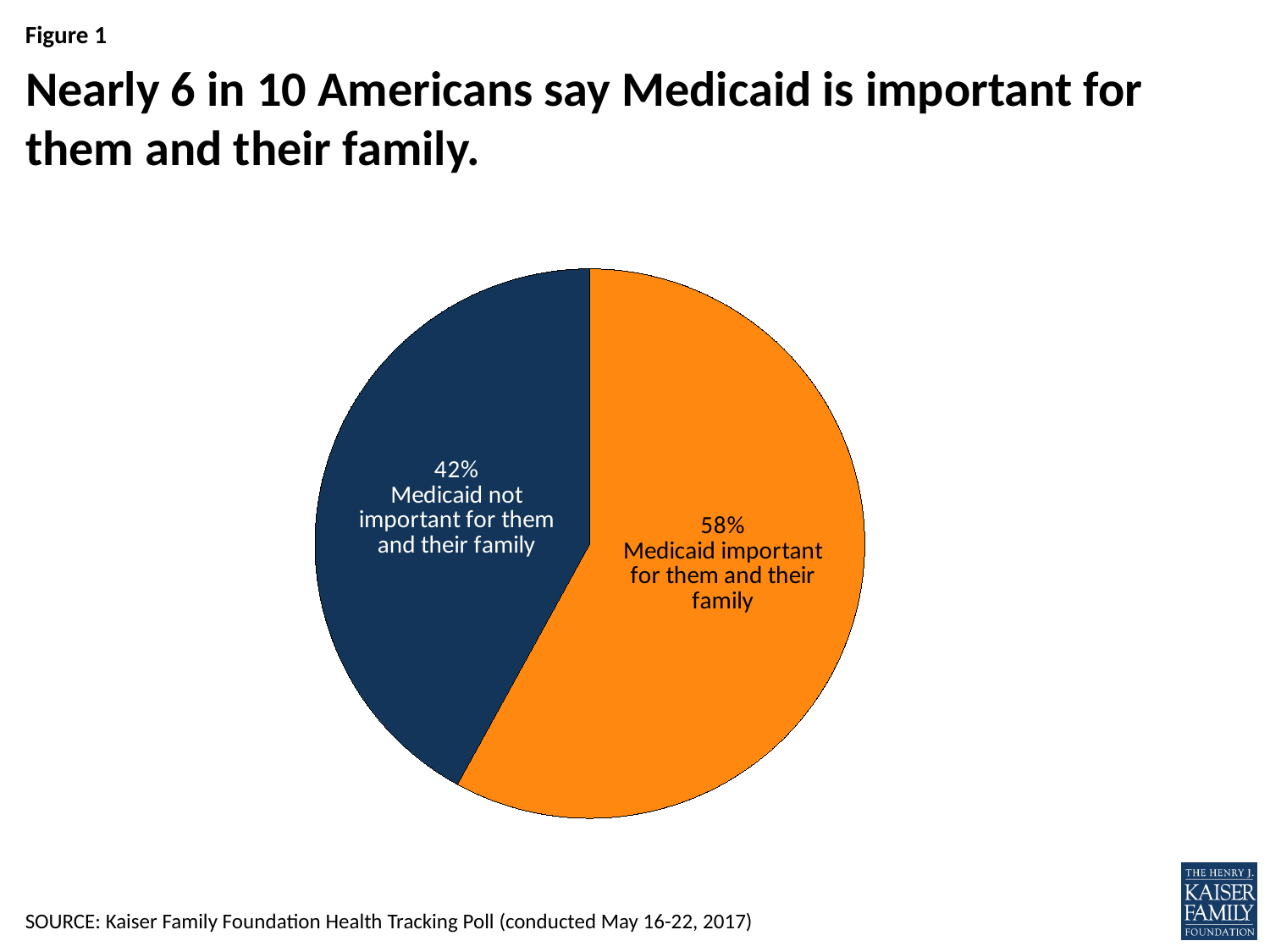
What colour is the slice for 'Medicaid important for them and their family'? Orange What percentage of Americans say Medicaid is important for them and their family? 58% What is the title of the chart on the slide? Nearly 6 in 10 Americans say Medicaid is important for them and their family. How many slices does the pie chart have? 2 Which category has the smallest share of the pie? Medicaid not important for them and their family What is the difference in percentage points between the 'Medicaid important' slice and the 'Medicaid not important' slice? 16 percentage points What share of the pie does the 'Medicaid important for them and their family' slice represent? 58% What is the total of the two slices shown in the pie chart? 100% What percentage of Americans say Medicaid is not important for them and their family? 42% Which category has the largest share of the pie? Medicaid important for them and their family What kind of chart is shown on the slide? Pie chart Which slice of the pie is larger: 'Medicaid important for them and their family' or 'Medicaid not important for them and their family'? Medicaid important for them and their family